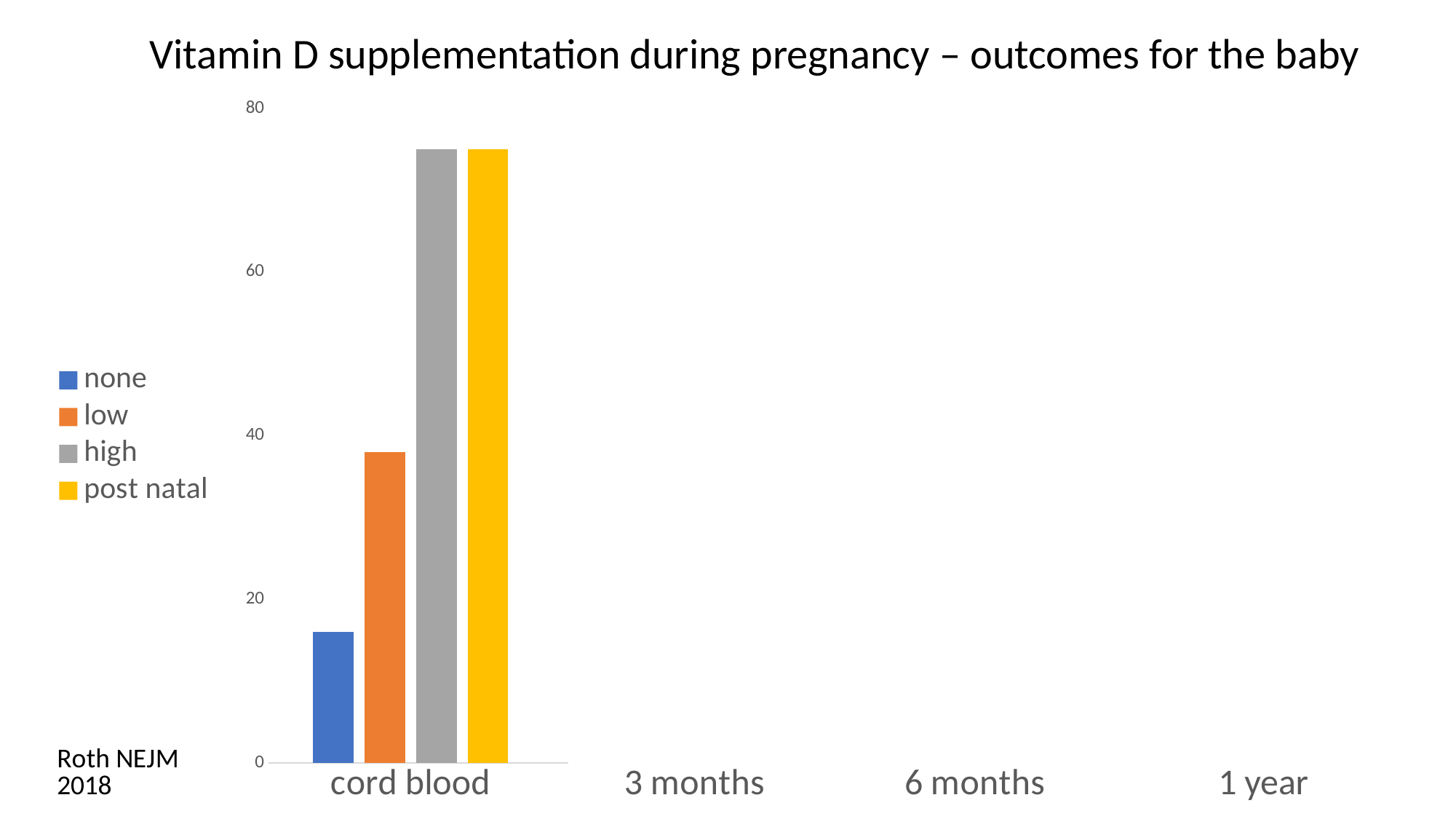
How many categories are shown on the x axis? 4 For cord blood, which is larger: the value for 'high' or the value for 'low'? high Which series is shown in orange in the legend? low Is the value for 'post natal' at cord blood greater or less than 60? greater What is the title of the chart? Vitamin D supplementation during pregnancy – outcomes for the baby What kind of chart is shown on the slide? bar chart Is the value for 'none' at cord blood greater or less than 20? less Is the value for 'low' at cord blood greater or less than 40? less Which series has the lowest value for cord blood? none For cord blood, which is larger: the value for 'low' or the value for 'none'? low How many series does the legend list? 4